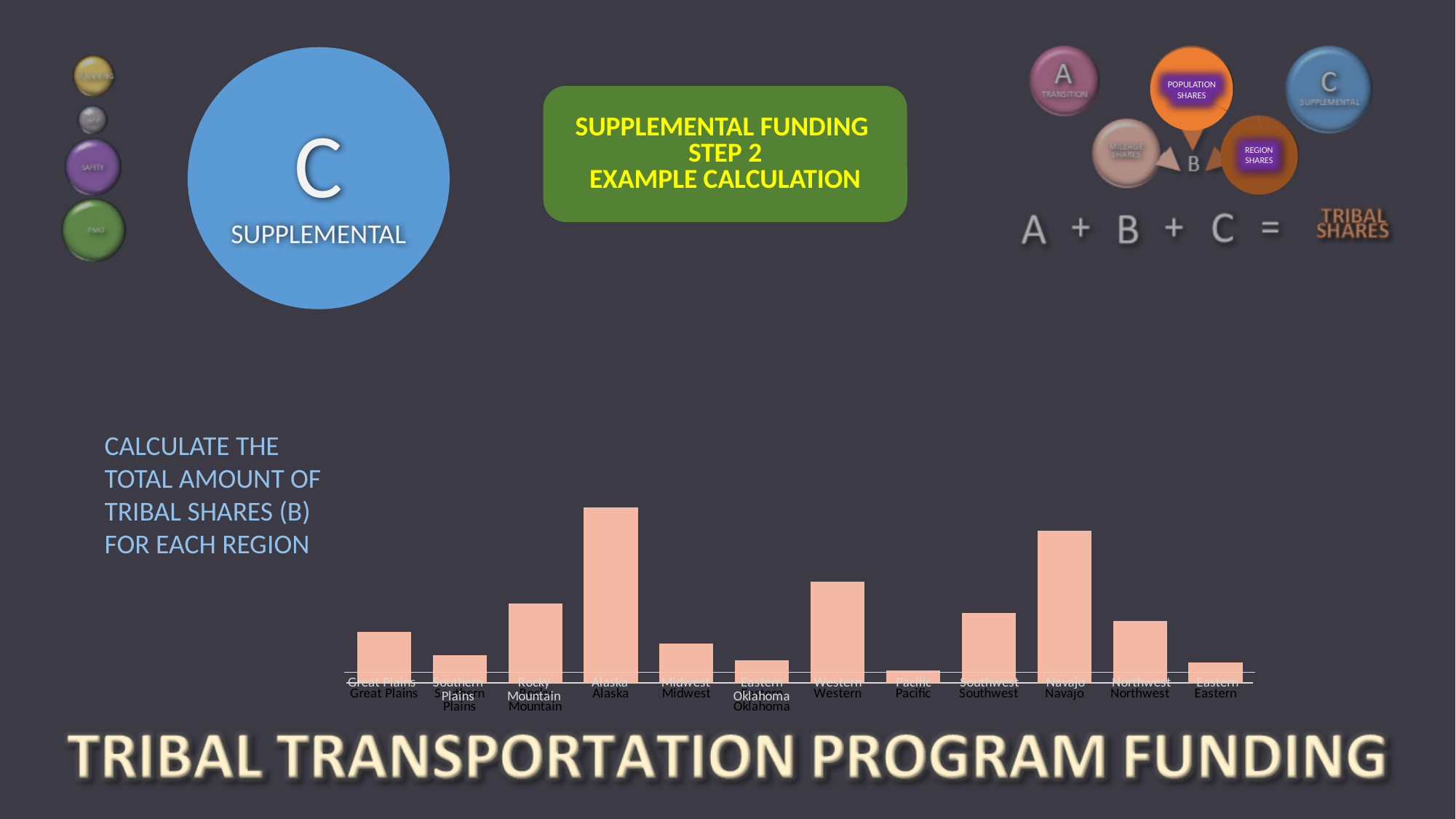
What kind of chart is shown on the slide? bar chart Which bar is taller, Pacific or Northwest? Northwest Which region has the second tallest bar in the chart? Navajo Which bar is taller, Alaska or Navajo? Alaska Which region has the shortest bar in the chart? Pacific Which bar is taller, Western or Rocky Mountain? Western What is the first region listed on the x axis of the chart? Great Plains What colour are the bars in the chart? light salmon (peach) How many regions are shown on the x axis of the bar chart? 12 Which region has the tallest bar in the chart? Alaska